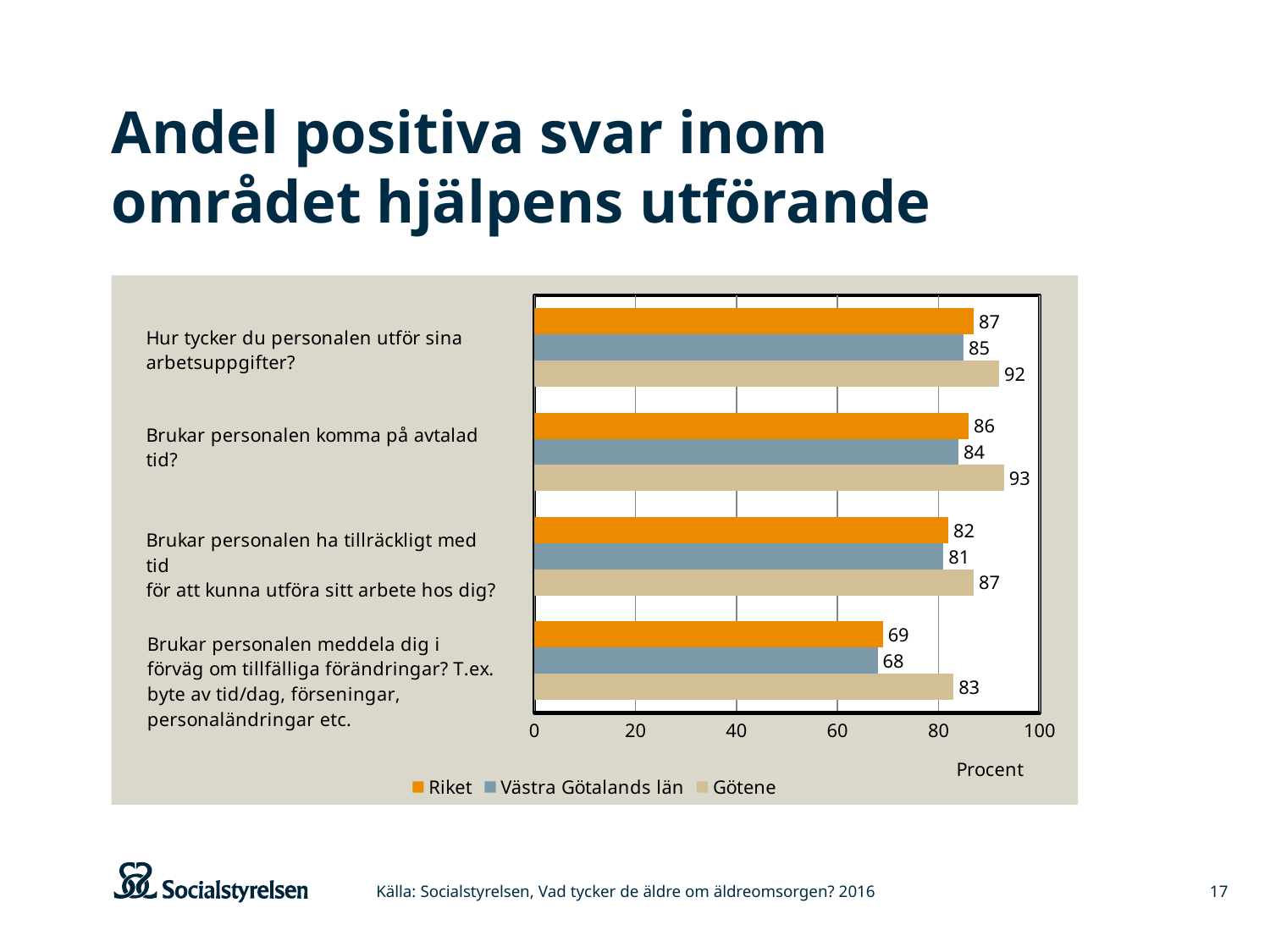
How many series does the legend list? 3 What is the value for Riket on "Hur tycker du personalen utför sina arbetsuppgifter?"? 87 Is the value for Götene on "Hur tycker du personalen utför sina arbetsuppgifter?" greater or less than 80? greater Which is larger on "Brukar personalen ha tillräckligt med tid för att kunna utföra sitt arbete hos dig?": Riket or Västra Götalands län? Riket How many questions (categories) are shown in the chart? 4 What kind of chart is shown on the slide? bar chart What is the value for Västra Götalands län on "Brukar personalen meddela dig i förväg om tillfälliga förändringar?"? 68 What is the difference between Götene and Riket on "Brukar personalen meddela dig i förväg om tillfälliga förändringar?"? 14 What is the value for Götene on "Brukar personalen komma på avtalad tid?"? 93 Which question has the highest value for Götene? Brukar personalen komma på avtalad tid? Which question has the lowest value for Riket? Brukar personalen meddela dig i förväg om tillfälliga förändringar? What is the label on the horizontal axis? Procent